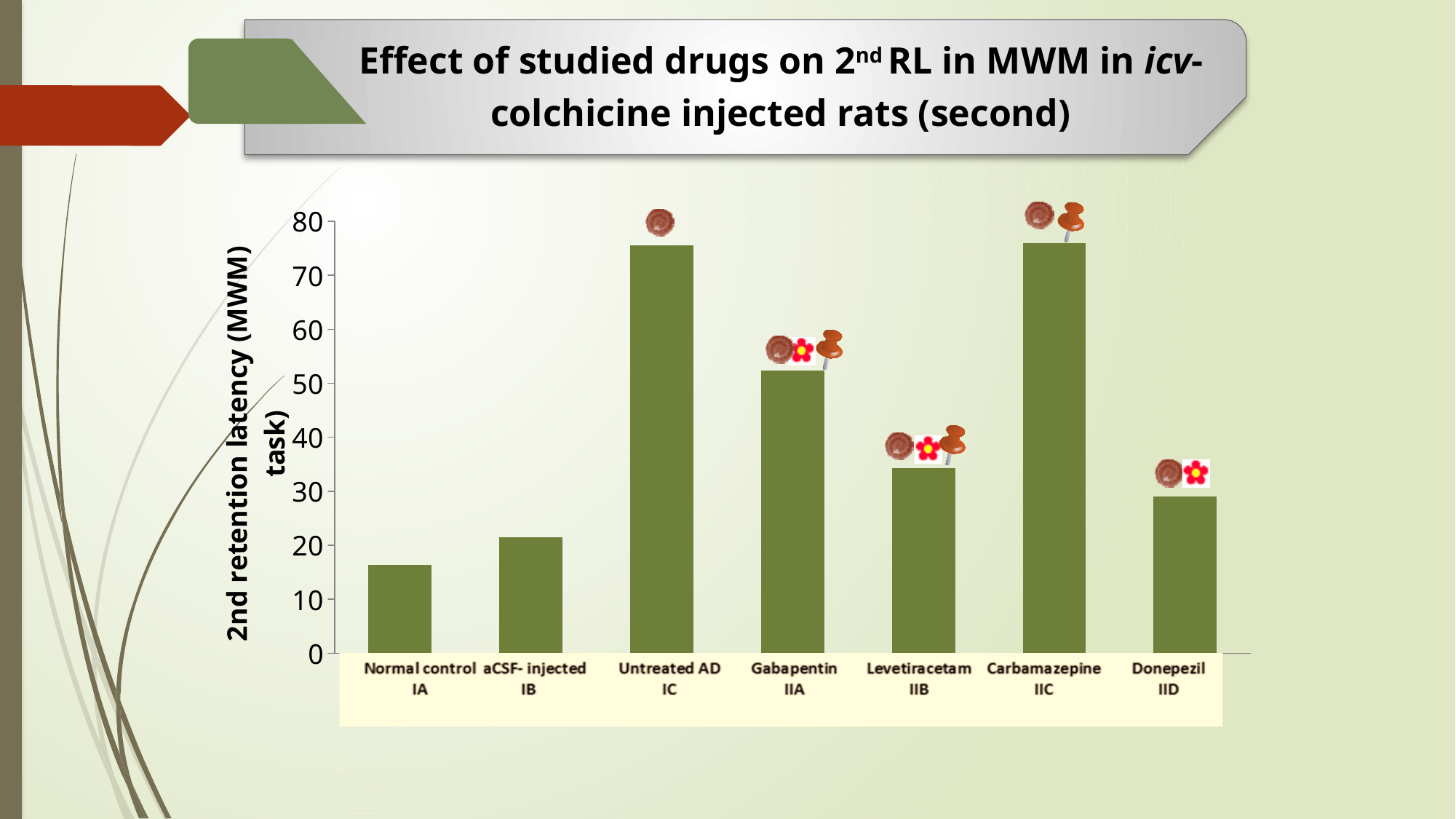
Is the value for Untreated AD IC greater or less than 70? greater Which is larger, the value for Gabapentin IIA or the value for Levetiracetam IIB? Gabapentin IIA Is the value for Levetiracetam IIB greater or less than 40? less How many categories (groups) are plotted on the x axis? 7 Is the value for Normal control IA greater or less than 20? less What kind of chart is shown on the slide? bar chart Which group has the lowest 2nd retention latency? Normal control IA What is the label of the y axis? 2nd retention latency (MWM task) Which is larger, the value for Donepezil IID or the value for aCSF- injected IB? Donepezil IID